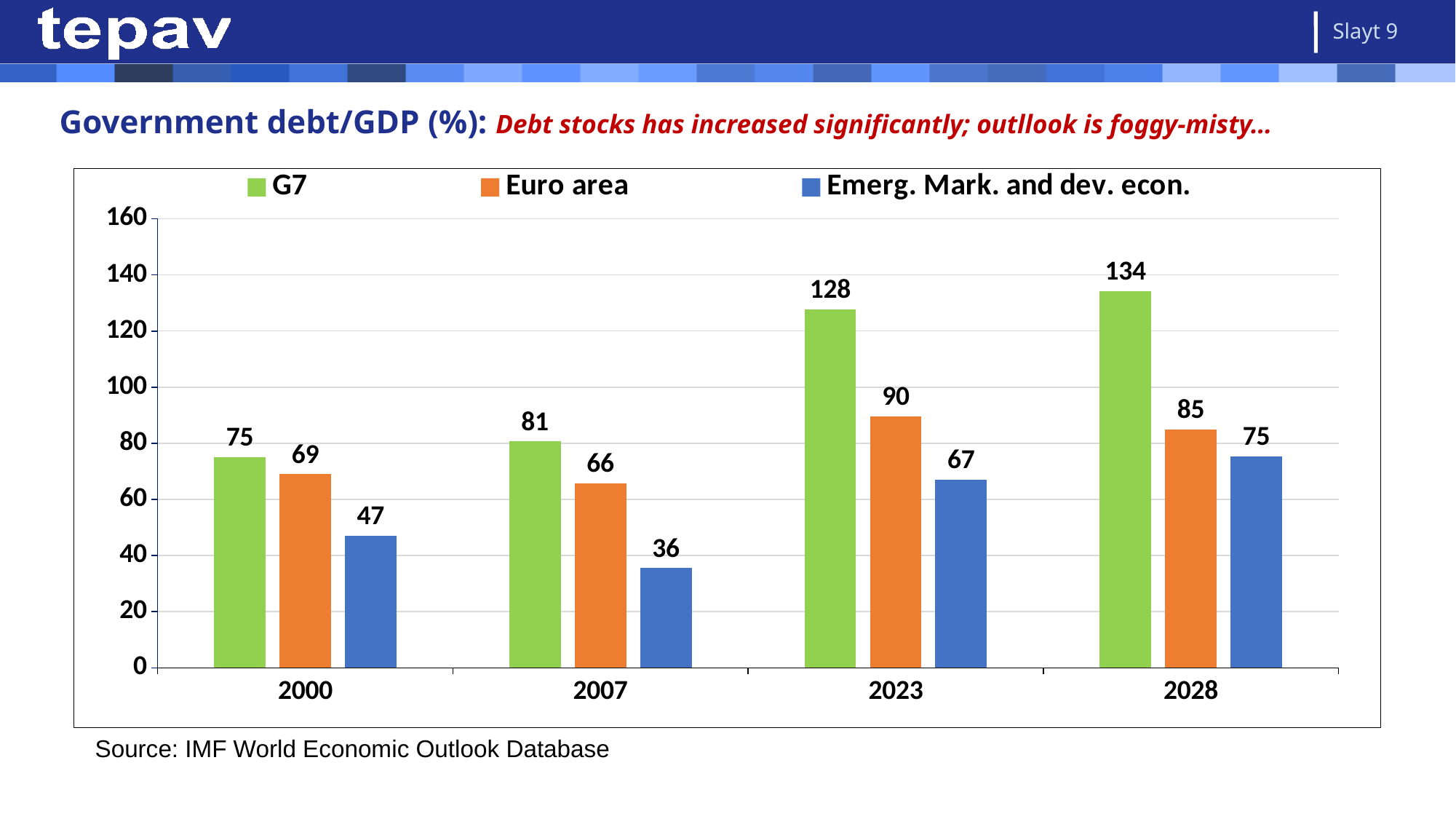
What is the Euro area value for 2000? 69 Which is larger in 2028: the Euro area value or the Emerg. Mark. and dev. econ. value? Euro area How many years are shown on the x axis? 4 In which year is the Emerg. Mark. and dev. econ. value lowest? 2007 What is the difference between the G7 value in 2028 and the G7 value in 2000? 59 What is the value for Emerg. Mark. and dev. econ. in 2007? 36 In which year is the G7 value highest? 2028 What is the G7 government debt/GDP value for 2023? 128 Does the Euro area value rise or fall from 2007 to 2023? Rise How many series does the legend list? 3 What kind of chart is shown on the slide? Bar chart Is the G7 value for 2023 greater or less than 120? greater